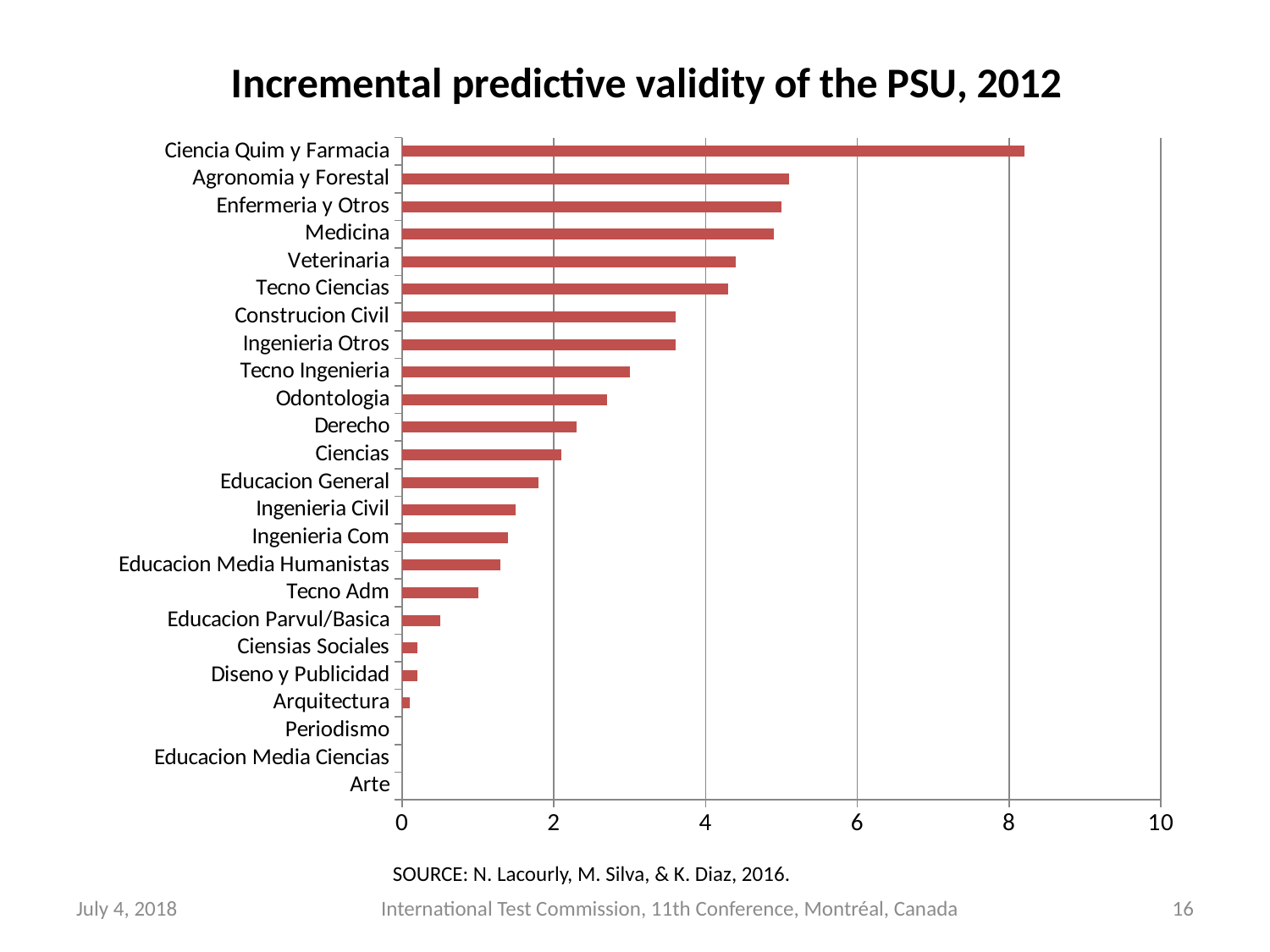
What is the title of the chart? Incremental predictive validity of the PSU, 2012 What kind of chart is shown on the slide? bar chart Is the value for Ciencia Quim y Farmacia greater or less than 8? greater Is the value for Educacion General greater or less than 2? less Is the value for Construcion Civil greater or less than 4? less Which category has the highest value in the chart? Ciencia Quim y Farmacia Which has the larger value, Tecno Adm or Ingenieria Civil? Ingenieria Civil How many categories are plotted in the chart? 24 Which has the larger value, Odontologia or Derecho? Odontologia